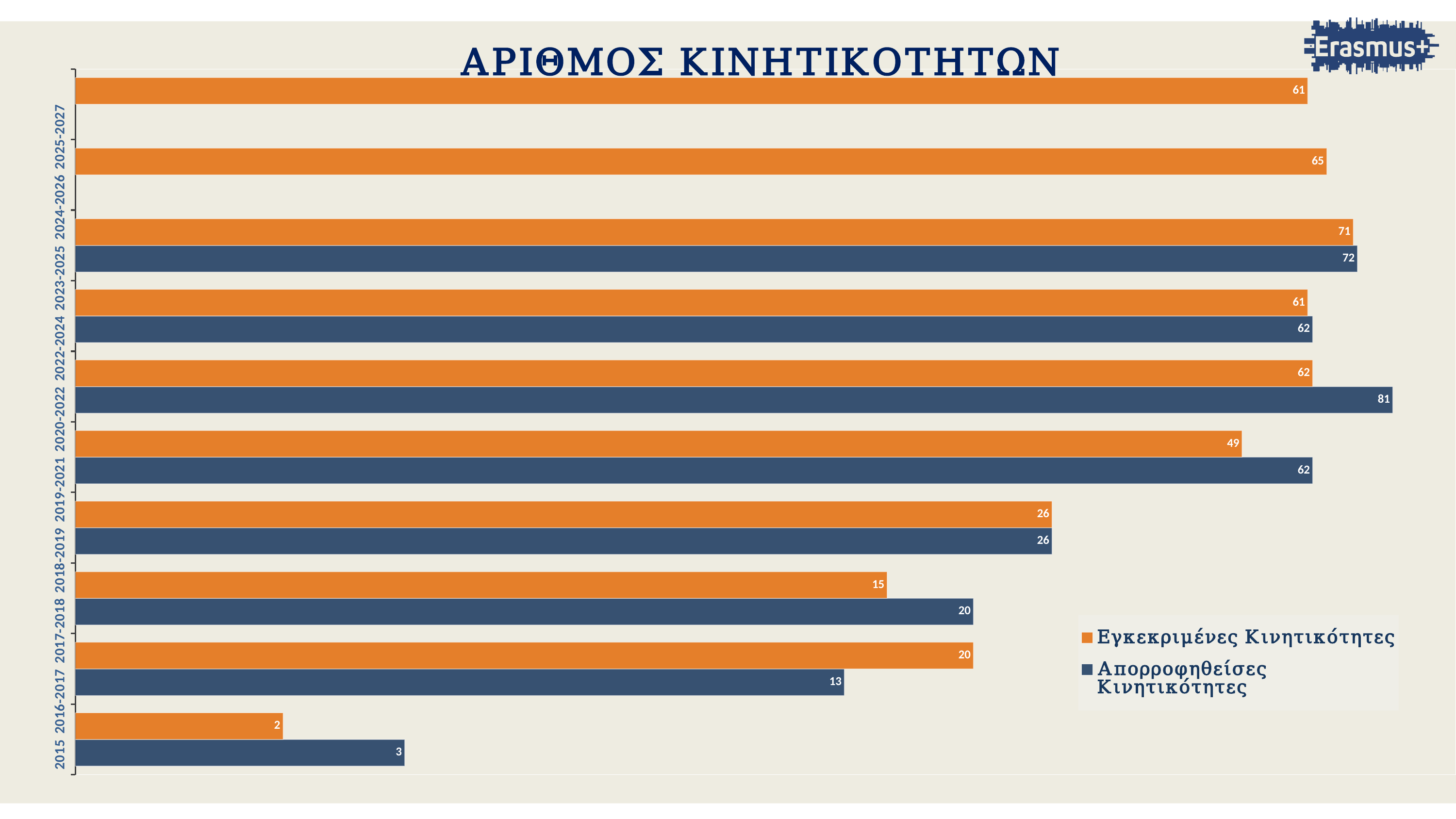
What is the title of the chart? ΑΡΙΘΜΟΣ ΚΙΝΗΤΙΚΟΤΗΤΩΝ What type of chart is shown on the slide? bar chart What is the difference between Εγκεκριμένες Κινητικότητες for 2023-2025 and for 2022-2024? 10 What is the value of Εγκεκριμένες Κινητικότητες for 2019-2021? 49 What is the value of Εγκεκριμένες Κινητικότητες for 2024-2026? 65 Which period has the lowest value for Εγκεκριμένες Κινητικότητες? 2015 What is the value of Απορροφηθείσες Κινητικότητες for 2020-2022? 81 What is the difference between Απορροφηθείσες Κινητικότητες and Εγκεκριμένες Κινητικότητες for 2020-2022? 19 Which period has the highest value for Απορροφηθείσες Κινητικότητες? 2020-2022 How many categories (periods) are shown on the vertical axis? 10 How many series does the legend list? 2 For 2016-2017, which is larger: Εγκεκριμένες Κινητικότητες or Απορροφηθείσες Κινητικότητες? Εγκεκριμένες Κινητικότητες